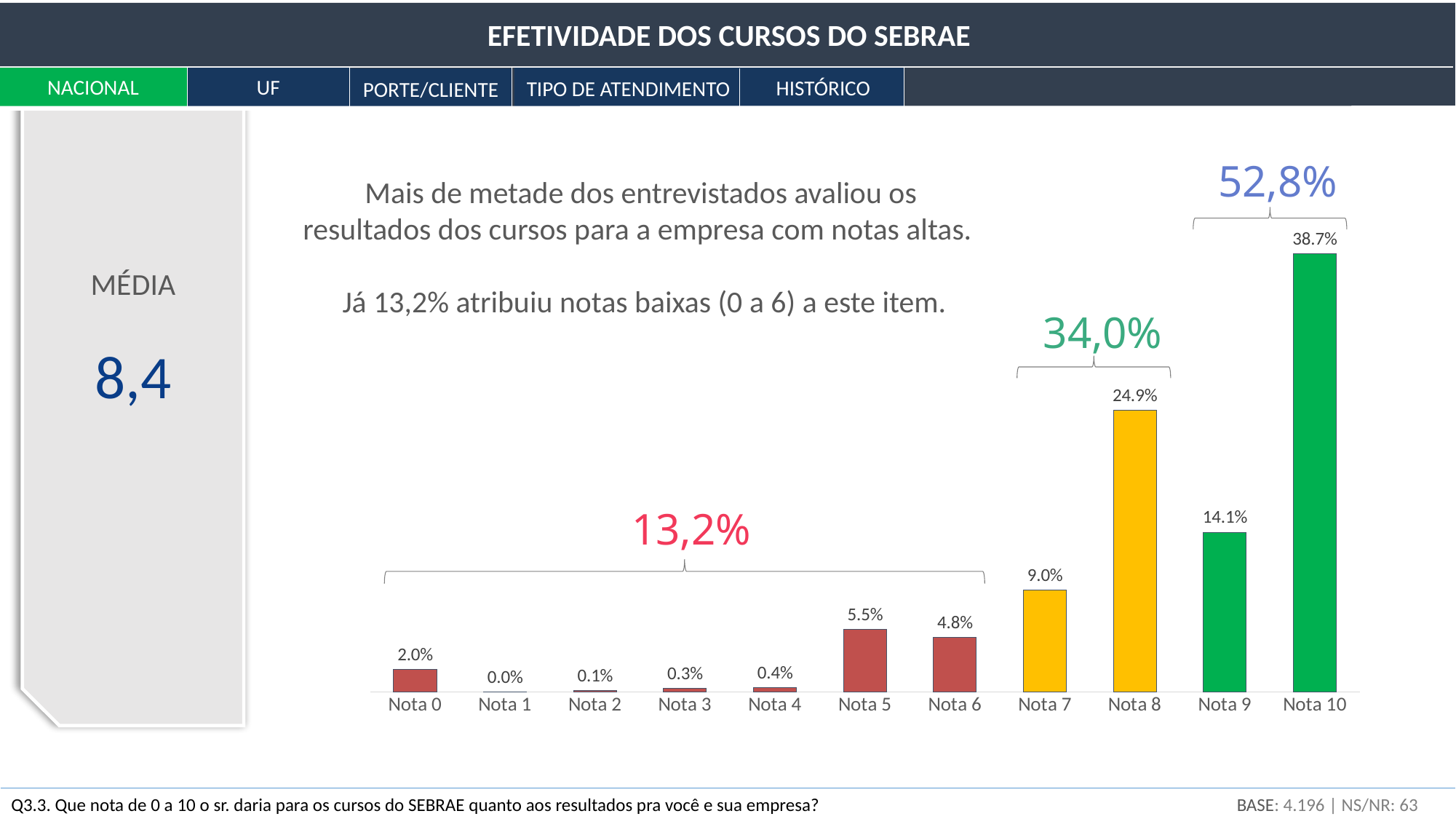
What is the combined share shown for Nota 0 to Nota 6 above the bracket? 13,2% What is the value for Nota 10? 38.7% What is the difference between the values for Nota 10 and Nota 9? 24.6% What is the value for Nota 8? 24.9% What is the value for Nota 5? 5.5% What kind of chart is shown? bar chart Which category has the lowest value? Nota 1 Which is larger, the value for Nota 7 or the value for Nota 6? Nota 7 Which category has the highest value? Nota 10 What is the value for Nota 1? 0.0% How many categories are shown on the x axis? 11 What is the combined share shown for Nota 9 and Nota 10 above the bracket? 52,8%